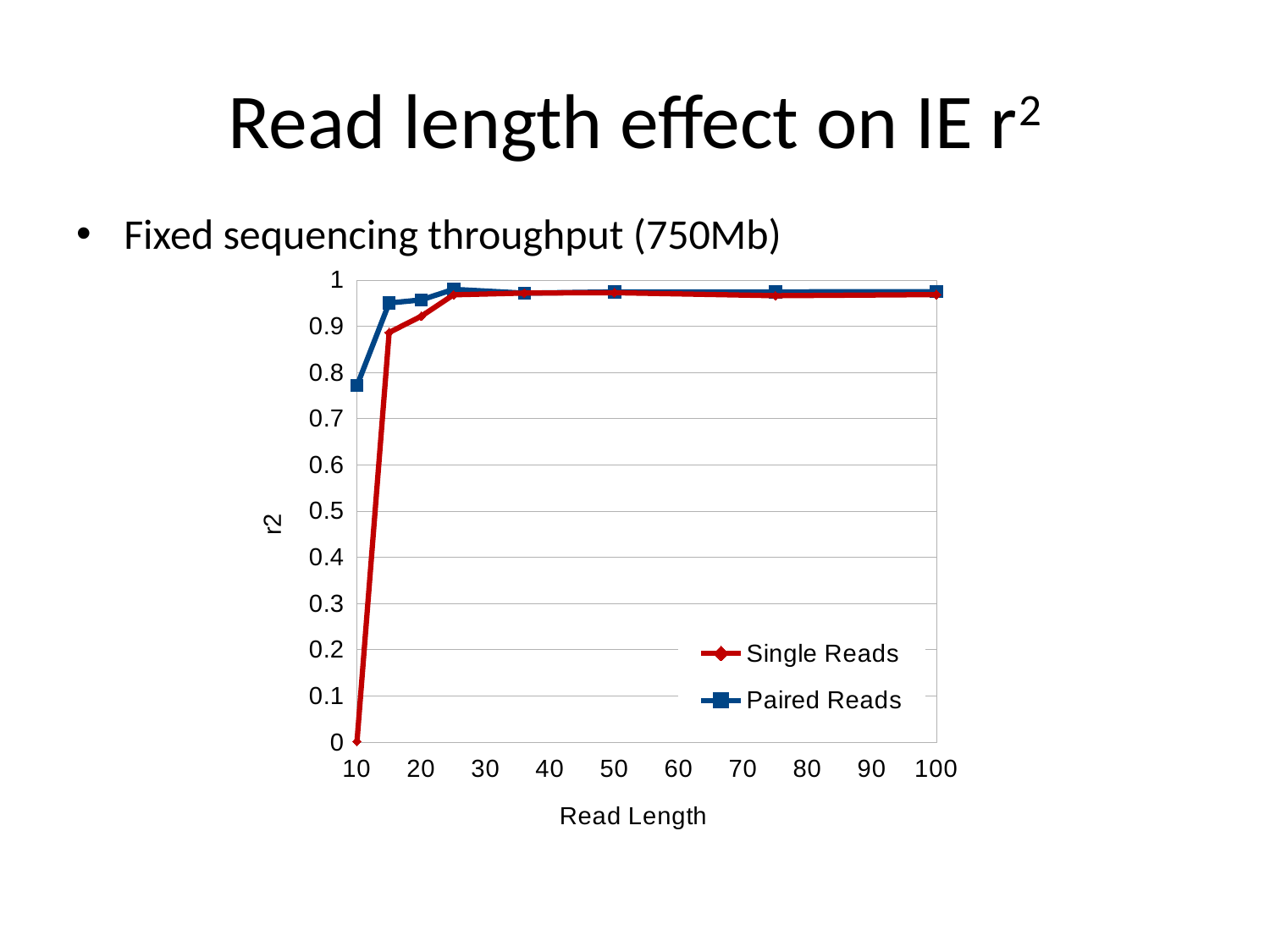
Is the r2 value for Paired Reads at read length 100 greater or less than 0.9? greater Does the r2 value for Single Reads rise or fall between read length 10 and read length 25? rise What is the label of the x axis? Read Length Is the r2 value for Paired Reads at read length 10 greater or less than 0.7? greater At read length 10, which series has the higher r2 value, Single Reads or Paired Reads? Paired Reads What are the two series named in the legend? Single Reads and Paired Reads At which read length does the Single Reads series have its lowest r2 value? 10 Is the r2 value for Single Reads at read length 15 greater or less than 0.8? greater What is the r2 value for Single Reads at read length 10? 0 What kind of chart is shown on the slide? line chart At read length 15, which series has the higher r2 value, Single Reads or Paired Reads? Paired Reads How many series does the legend list? 2